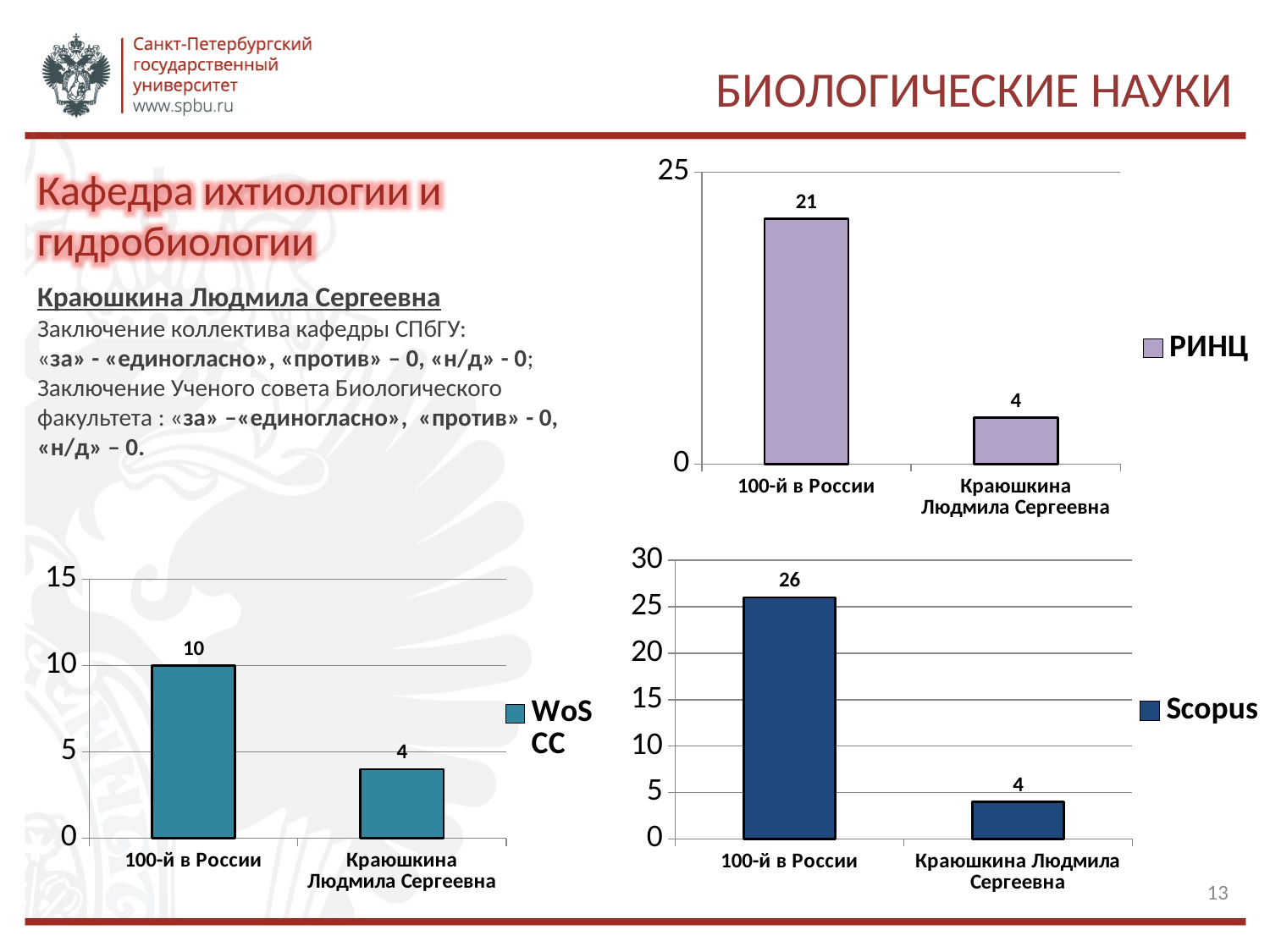
In the WoS CC chart, what is the value for Краюшкина Людмила Сергеевна? 4 In the WoS CC chart, what is the value for 100-й в России? 10 In the Scopus chart, what is the difference between the values for 100-й в России and Краюшкина Людмила Сергеевна? 22 In the Scopus chart, what is the value for 100-й в России? 26 In the Scopus chart, which category has the lowest value? Краюшкина Людмила Сергеевна In the РИНЦ chart, what is the value for 100-й в России? 21 In the Scopus chart, what is the value for Краюшкина Людмила Сергеевна? 4 In the РИНЦ chart, what is the difference between the values for 100-й в России and Краюшкина Людмила Сергеевна? 17 In the WoS CC chart, which category has the highest value? 100-й в России How many categories are shown in the WoS CC chart? 2 What kind of chart is the Scopus chart? Bar chart In the РИНЦ chart, what is the value for Краюшкина Людмила Сергеевна? 4